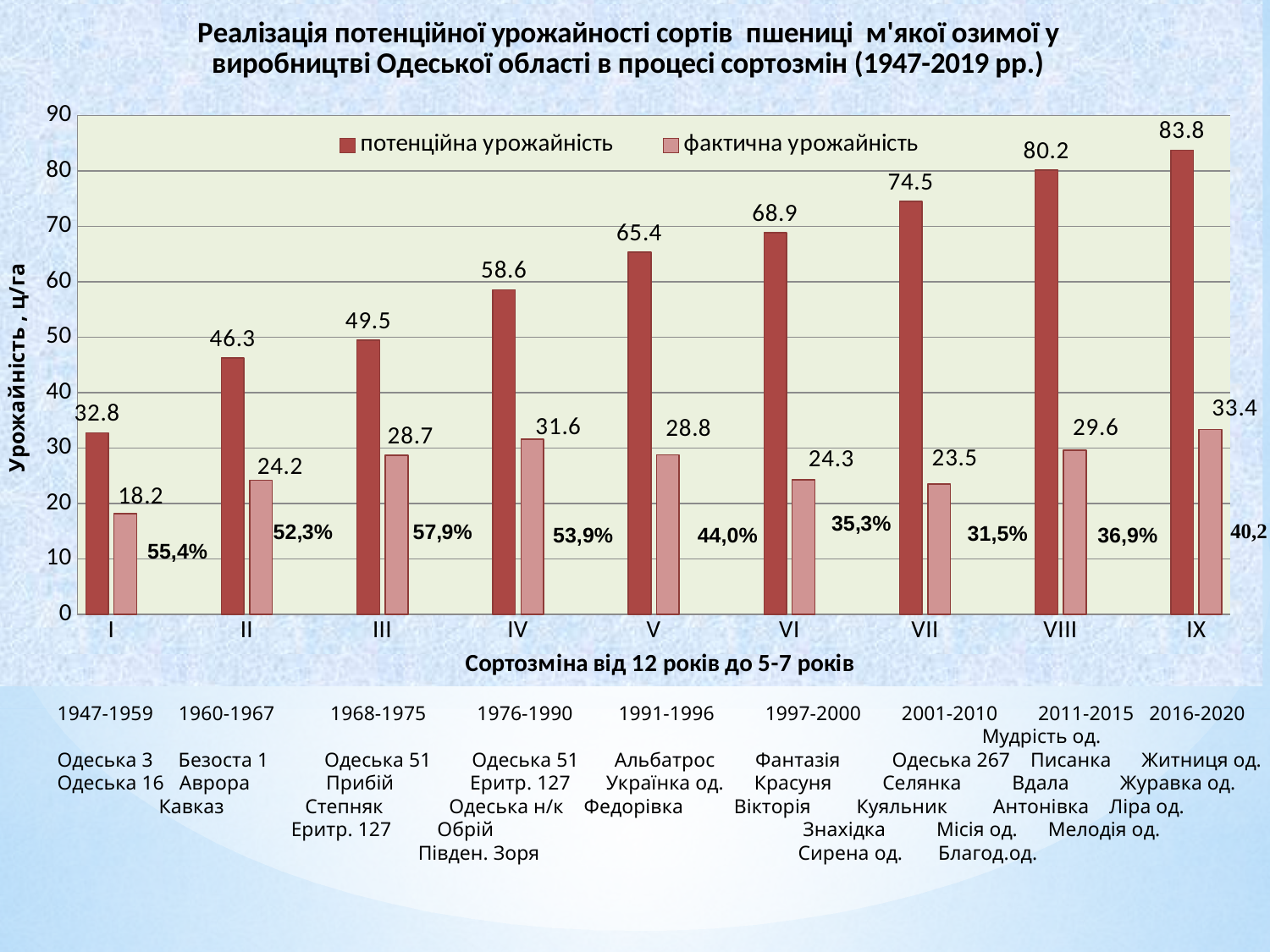
How many categories are shown on the x axis? 9 Which category has the highest фактична урожайність? IX What is the фактична урожайність value for category IV? 31.6 Which is larger: фактична урожайність for category III or for category VI? category III Is the потенційна урожайність for category VII greater or less than 70? greater Does потенційна урожайність rise or fall from category I to category IX? rise What is the потенційна урожайність value for category IX? 83.8 Which category has the lowest потенційна урожайність? I How many series does the legend list? 2 What is the difference between потенційна урожайність and фактична урожайність for category V? 36.6 What is the y-axis label of the chart? Урожайність , ц/га What kind of chart is shown on the slide? bar chart